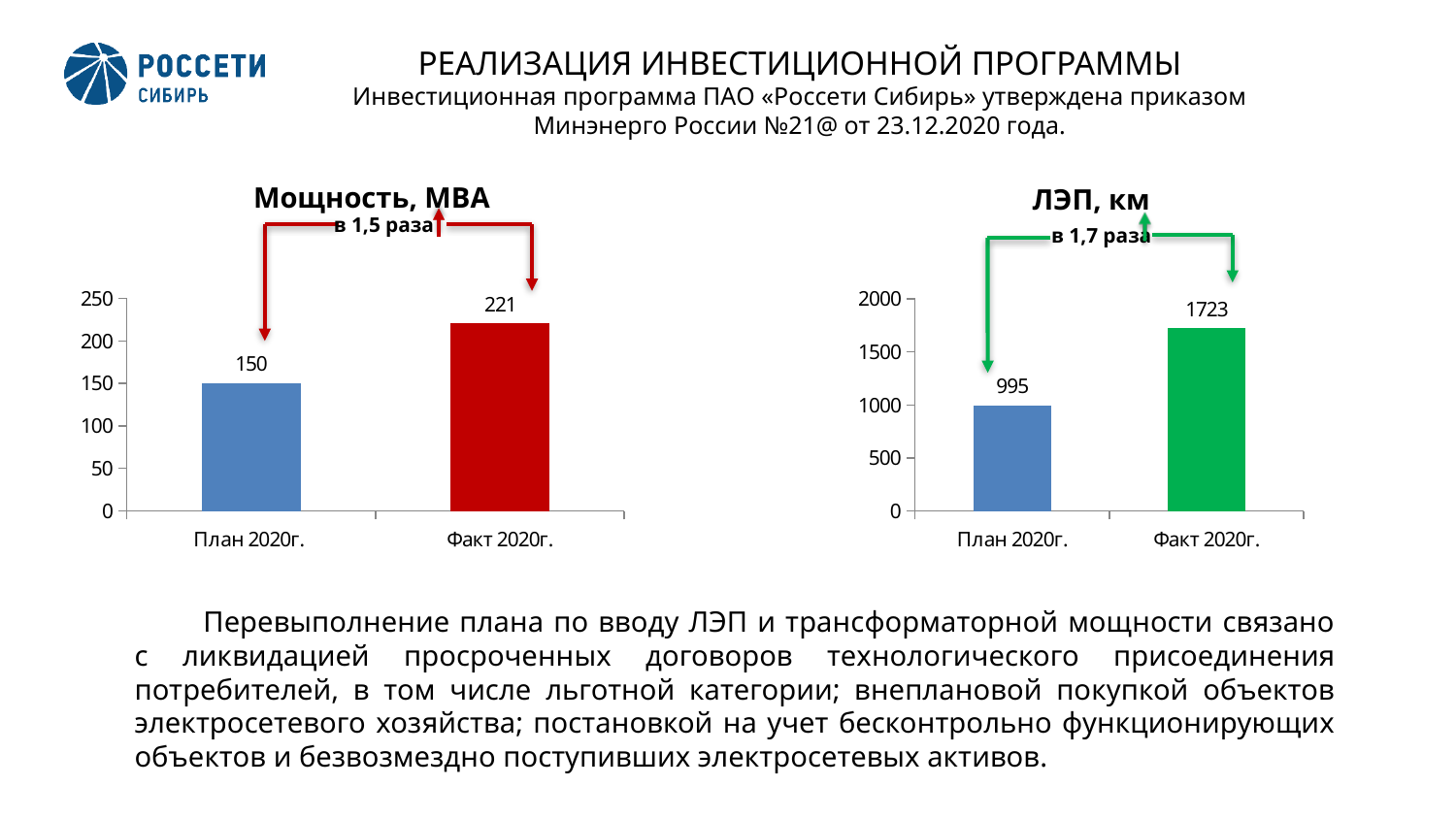
In the 'Мощность, МВА' chart, what is the value for План 2020г.? 150 In the 'Мощность, МВА' chart, what is the difference between Факт 2020г. and План 2020г.? 71 In the 'ЛЭП, км' chart, what is the difference between Факт 2020г. and План 2020г.? 728 How many categories are shown in the 'Мощность, МВА' chart? 2 In the 'ЛЭП, км' chart, what is the value for Факт 2020г.? 1723 What type of chart is the 'ЛЭП, км' chart? bar chart In the 'Мощность, МВА' chart, what is the value for Факт 2020г.? 221 In the 'ЛЭП, км' chart, what is the value for План 2020г.? 995 In the 'ЛЭП, км' chart, which category has the lowest value? План 2020г. What ratio is annotated above the bars in the 'ЛЭП, км' chart? в 1,7 раза In the 'Мощность, МВА' chart, which category has the highest value? Факт 2020г. In the 'ЛЭП, км' chart, is the value for Факт 2020г. greater or less than 1500? greater